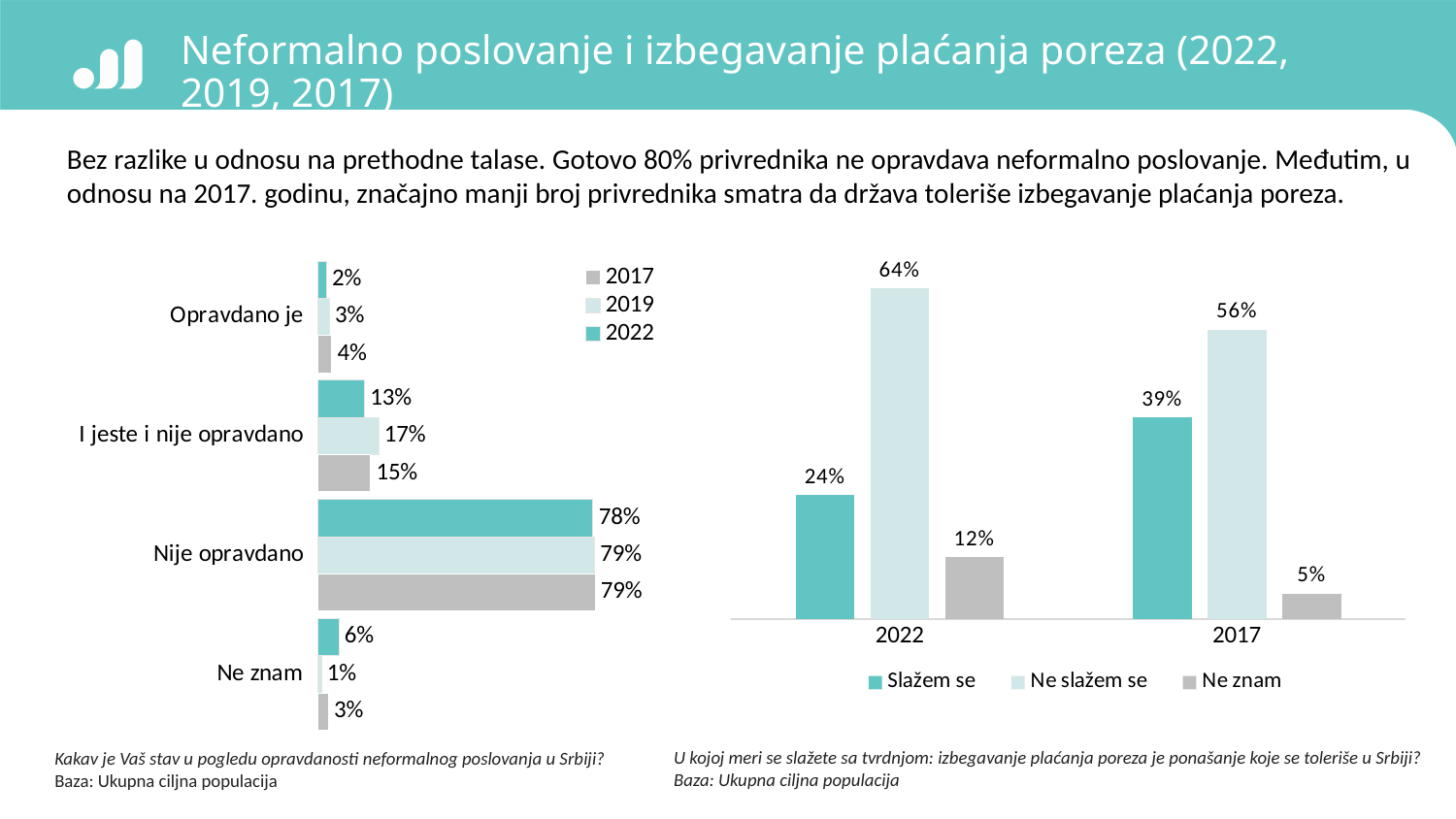
In the left chart, how many categories are shown on the vertical axis? 4 What type of chart is the right chart? Bar chart In the left chart, what is the difference between the 2019 and 2022 values for "I jeste i nije opravdano"? 4% In the right chart, what is the "Ne slažem se" value for 2022? 64% In the right chart, what is the "Slažem se" value for 2017? 39% In the left chart, what is the 2017 value for "Ne znam"? 3% In the left chart, which category has the highest 2022 value? Nije opravdano In the left chart, how many series does the legend list? 3 In the left chart, what is the 2022 value for "Nije opravdano"? 78% In the right chart, what is the difference between the "Ne znam" values for 2022 and 2017? 7% In the left chart, what is the 2019 value for "I jeste i nije opravdano"? 17% In the right chart, which is larger: "Slažem se" for 2022 or "Slažem se" for 2017? 2017